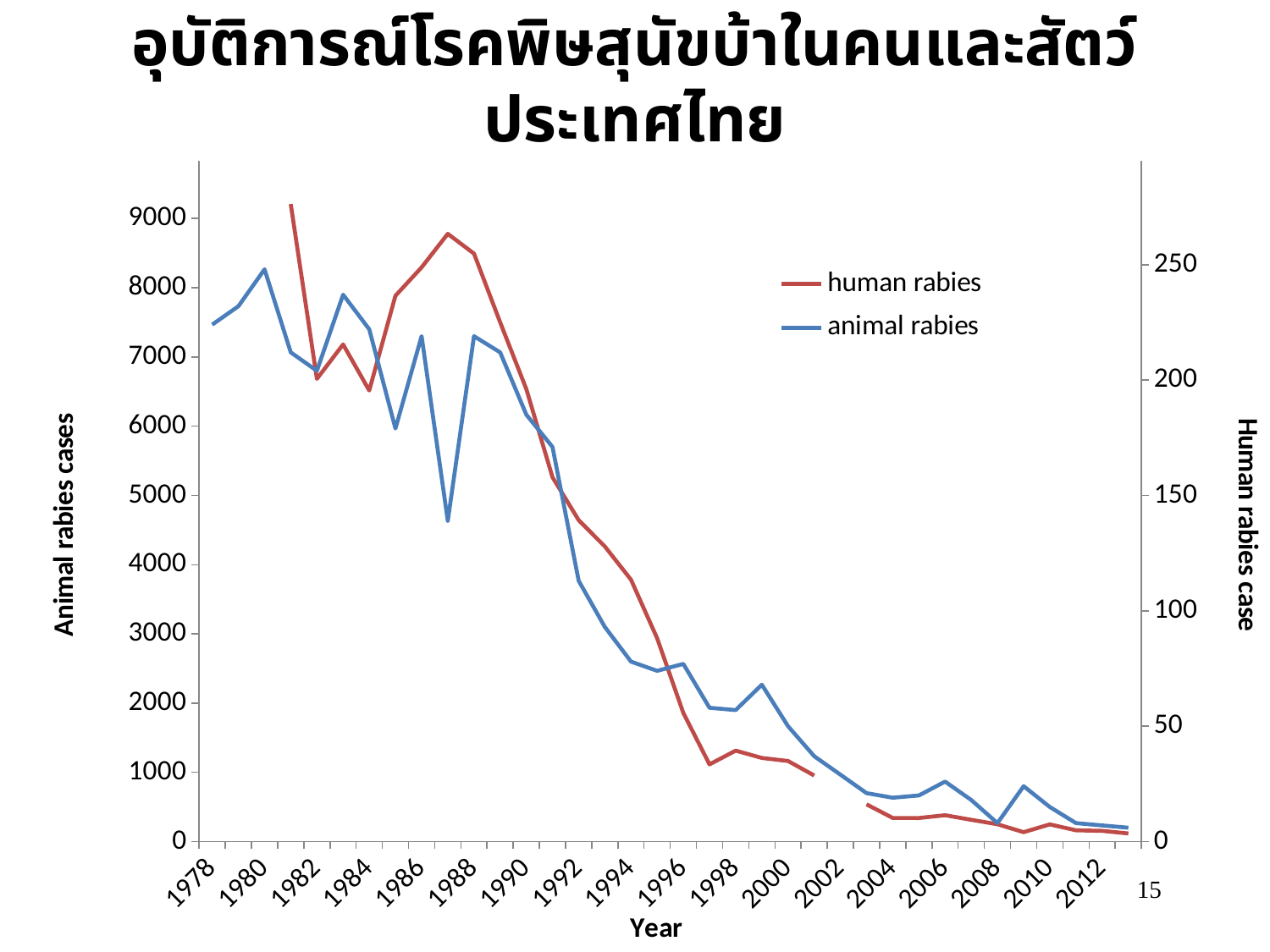
What kind of chart is shown on the slide? line chart How many series does the legend list? 2 What are the two series named in the legend? human rabies and animal rabies Is the value for animal rabies in 1987 greater or less than 5000? less What is the title of the left vertical axis? Animal rabies cases Overall, do human rabies cases rise or fall from 1981 to 2013? fall Is the value for human rabies in 1981 greater or less than 250? greater Overall, do animal rabies cases rise or fall from 1978 to 2013? fall Which year has the highest value for animal rabies? 1980 Which is larger for animal rabies: the value in 1980 or the value in 1985? 1980